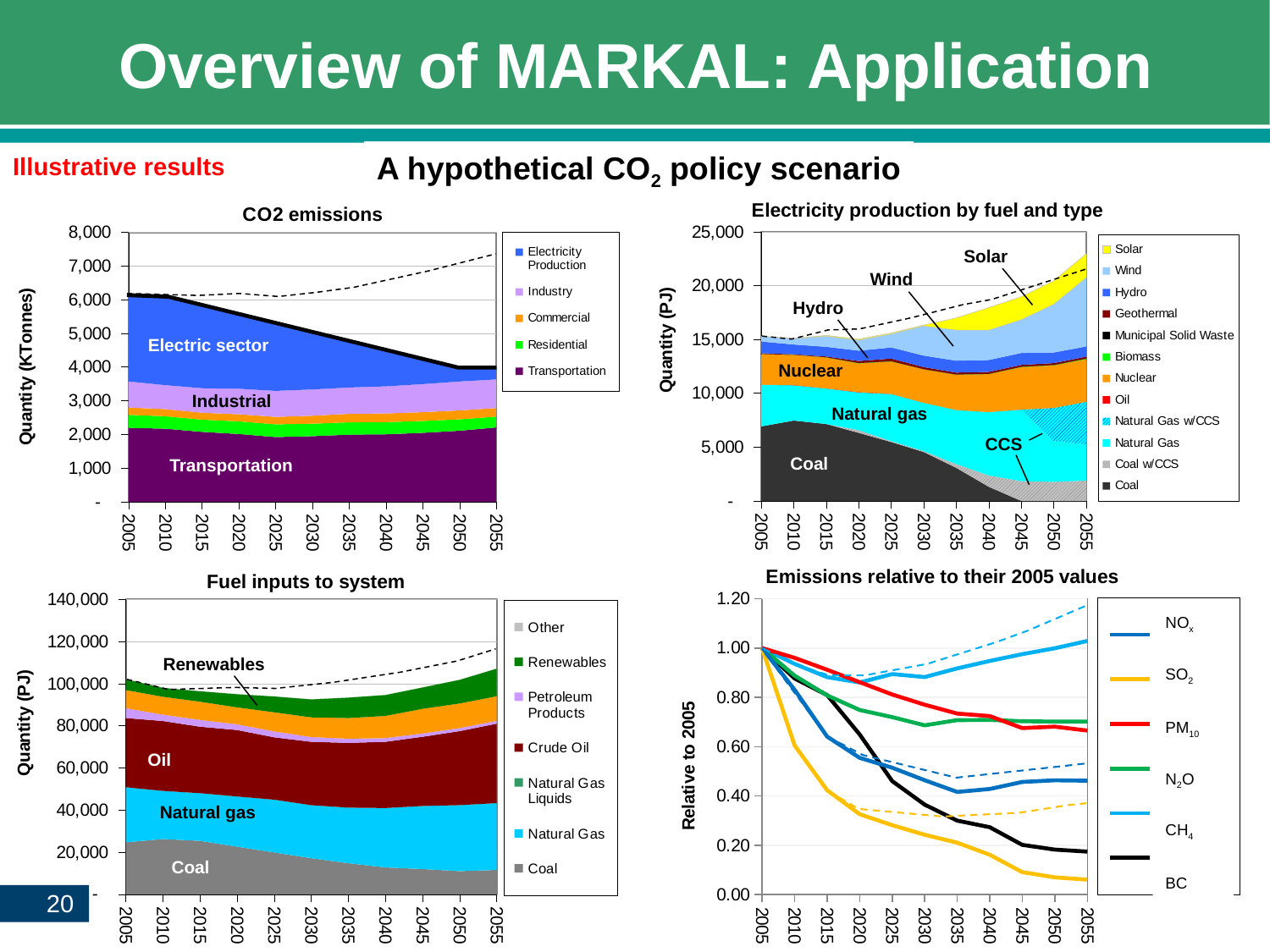
In the 'Emissions relative to their 2005 values' chart, which series has the lowest value in 2055? SO2 What type of chart is the 'Emissions relative to their 2005 values' chart? line chart In the 'Electricity production by fuel and type' chart, how many entries does the legend list? 12 In the 'Emissions relative to their 2005 values' chart, how many series does the legend list? 6 In the 'Emissions relative to their 2005 values' chart, is the SO2 value in 2055 greater or less than 0.20? less In the 'Emissions relative to their 2005 values' chart, what is the value of every series in 2005? 1.00 In the 'Emissions relative to their 2005 values' chart, does the SO2 line rise or fall from 2005 to 2055? fall In the 'Emissions relative to their 2005 values' chart, which is larger in 2055, NOx or BC? NOx In the 'CO2 emissions' chart, how many years are shown on the x axis? 11 In the 'Fuel inputs to system' chart, is the Coal value in 2005 greater or less than 20,000? greater In the 'Electricity production by fuel and type' chart, is the total electricity production in 2055 greater or less than 20,000? greater In the 'Emissions relative to their 2005 values' chart, which series has the highest value in 2055? CH4